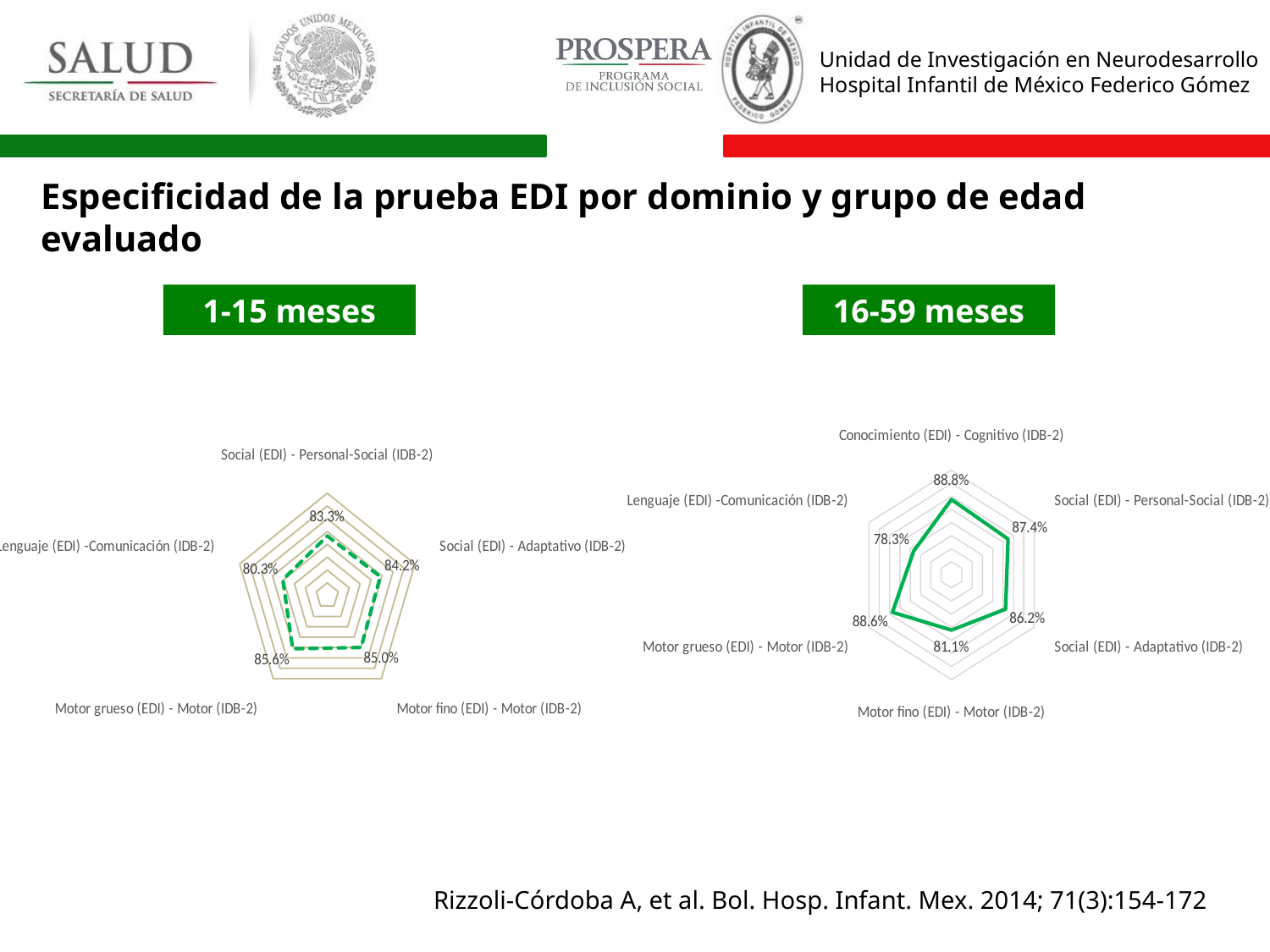
In the 16-59 meses chart, which domain has the lowest value? Lenguaje (EDI) - Comunicación (IDB-2) How many domains are plotted in the 16-59 meses chart? 6 In the 1-15 meses chart, which domain has the lowest value? Lenguaje (EDI) - Comunicación (IDB-2) In the 16-59 meses chart, what is the value for Motor fino (EDI) - Motor (IDB-2)? 81.1% What kind of chart is used for the 16-59 meses data? Radar chart In the 16-59 meses chart, what is the value for Conocimiento (EDI) - Cognitivo (IDB-2)? 88.8% In the 16-59 meses chart, which is larger: Social (EDI) - Personal-Social (IDB-2) or Social (EDI) - Adaptativo (IDB-2)? Social (EDI) - Personal-Social (IDB-2) How many domains are plotted in the 1-15 meses chart? 5 In the 1-15 meses chart, what is the value for Motor grueso (EDI) - Motor (IDB-2)? 85.6% In the 16-59 meses chart, what is the difference between Conocimiento (EDI) - Cognitivo (IDB-2) and Lenguaje (EDI) - Comunicación (IDB-2)? 10.5% In the 1-15 meses chart, what is the difference between Motor grueso (EDI) - Motor (IDB-2) and Social (EDI) - Personal-Social (IDB-2)? 2.3% In the 1-15 meses chart, what is the value for Lenguaje (EDI) - Comunicación (IDB-2)? 80.3%